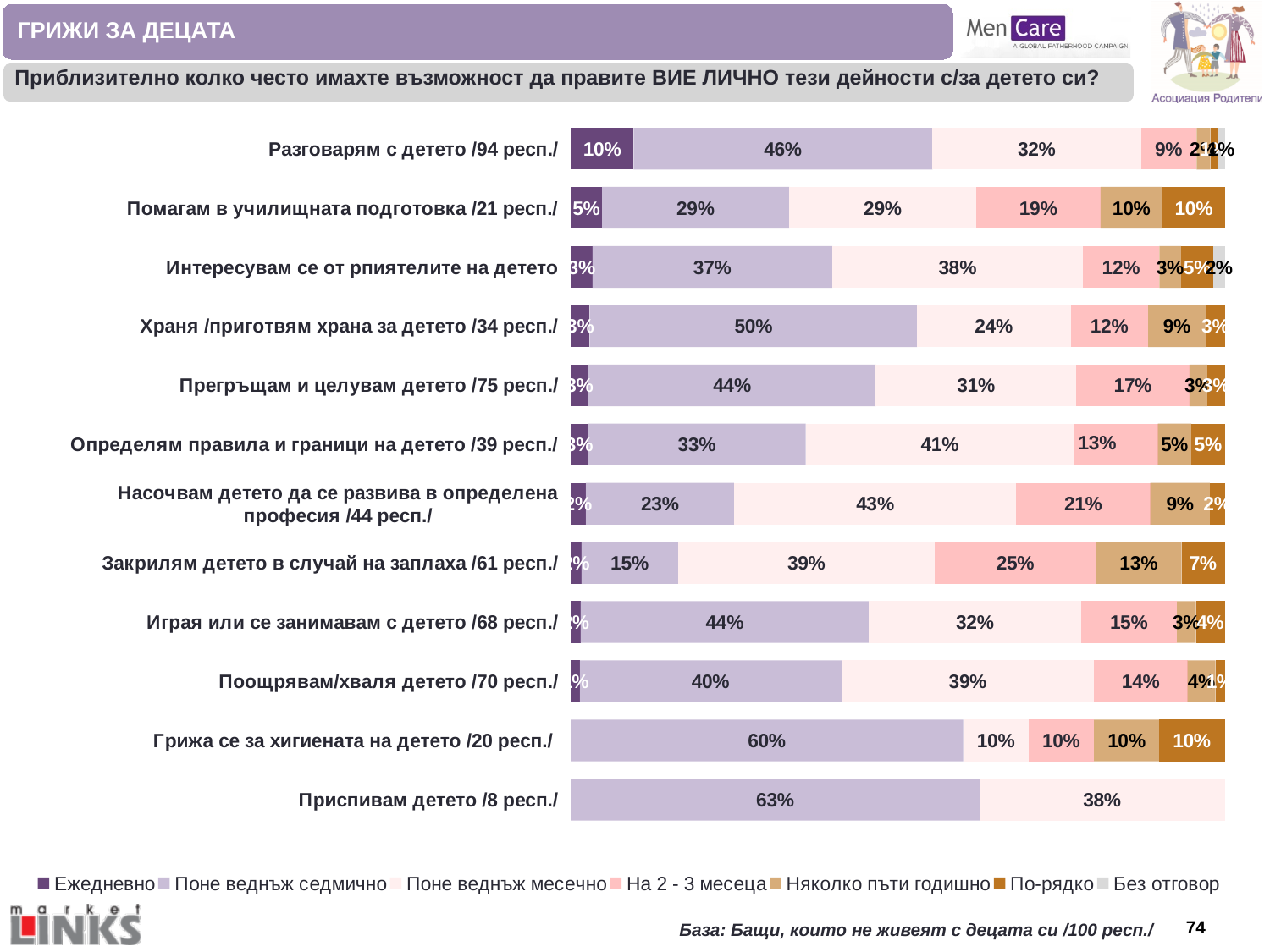
What is the 'На 2 - 3 месеца' value for 'Закрилям детето в случай на заплаха /61 респ./'? 25% Which category has the lowest 'Поне веднъж седмично' value? Закрилям детето в случай на заплаха /61 респ./ Which is larger: the 'Поне веднъж месечно' value for 'Поощрявам/хваля детето /70 респ./' or for 'Играя или се занимавам с детето /68 респ./'? Поощрявам/хваля детето /70 респ./ What kind of chart is shown on the slide? stacked bar chart What is the difference between the 'Поне веднъж седмично' values for 'Храня /приготвям храна за детето /34 респ./' and 'Определям правила и граници на детето /39 респ./'? 17% What is the 'Поне веднъж месечно' value for 'Насочвам детето да се развива в определена професия /44 респ./'? 43% What is the 'Поне веднъж седмично' value for 'Приспивам детето /8 респ./'? 63% Which category has the highest 'Поне веднъж седмично' value? Приспивам детето /8 респ./ What is the 'Поне веднъж седмично' value for 'Разговарям с детето /94 респ./'? 46% How many activity categories are plotted in the chart? 12 Which legend entry is shown in the darkest purple colour? Ежедневно How many series does the legend list? 7